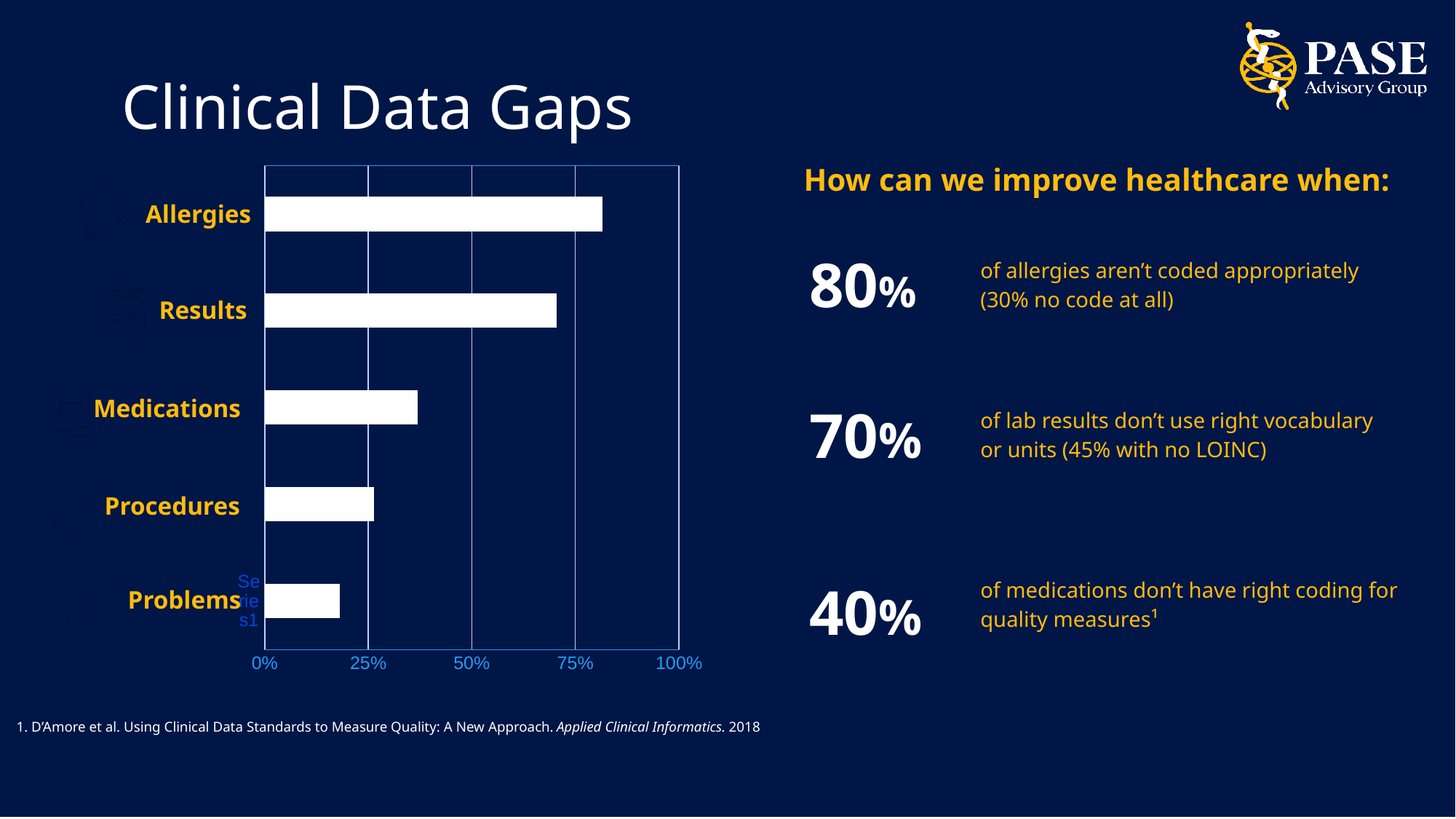
How many categories are plotted in the bar chart? 5 Which has the larger value in the chart, Procedures or Problems? Procedures What kind of chart is shown on the slide? bar chart Which category has the longest bar in the chart? Allergies Is the value for Medications greater or less than 50%? less Is the value for Allergies greater or less than 75%? greater Going down the chart from Allergies to Problems, do the bar values increase or decrease? decrease Is the value for Problems greater or less than 25%? less Which category has the shortest bar in the chart? Problems What is the highest value shown on the chart's horizontal axis? 100% Which has the larger value in the chart, Results or Medications? Results